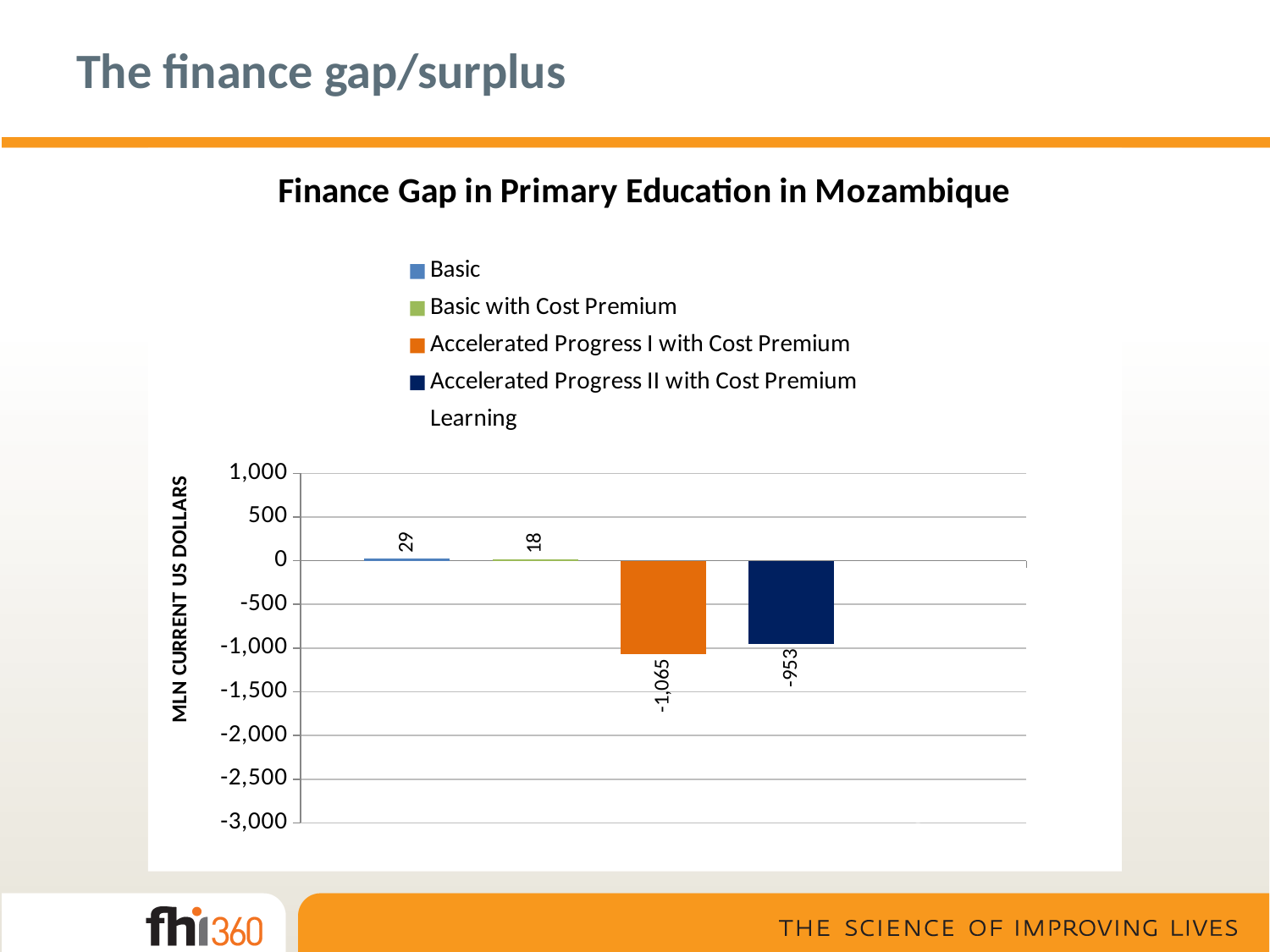
Is the value for Accelerated Progress I with Cost Premium greater or less than -1,000? less What is the title of the vertical axis? MLN CURRENT US DOLLARS Which series has the highest value? Basic What is the difference between the values for Basic and Basic with Cost Premium? 11 Which series has the lowest value? Accelerated Progress I with Cost Premium What is the value for Accelerated Progress I with Cost Premium? -1,065 What is the value for Basic with Cost Premium? 18 What is the value for Basic in the Finance Gap in Primary Education in Mozambique chart? 29